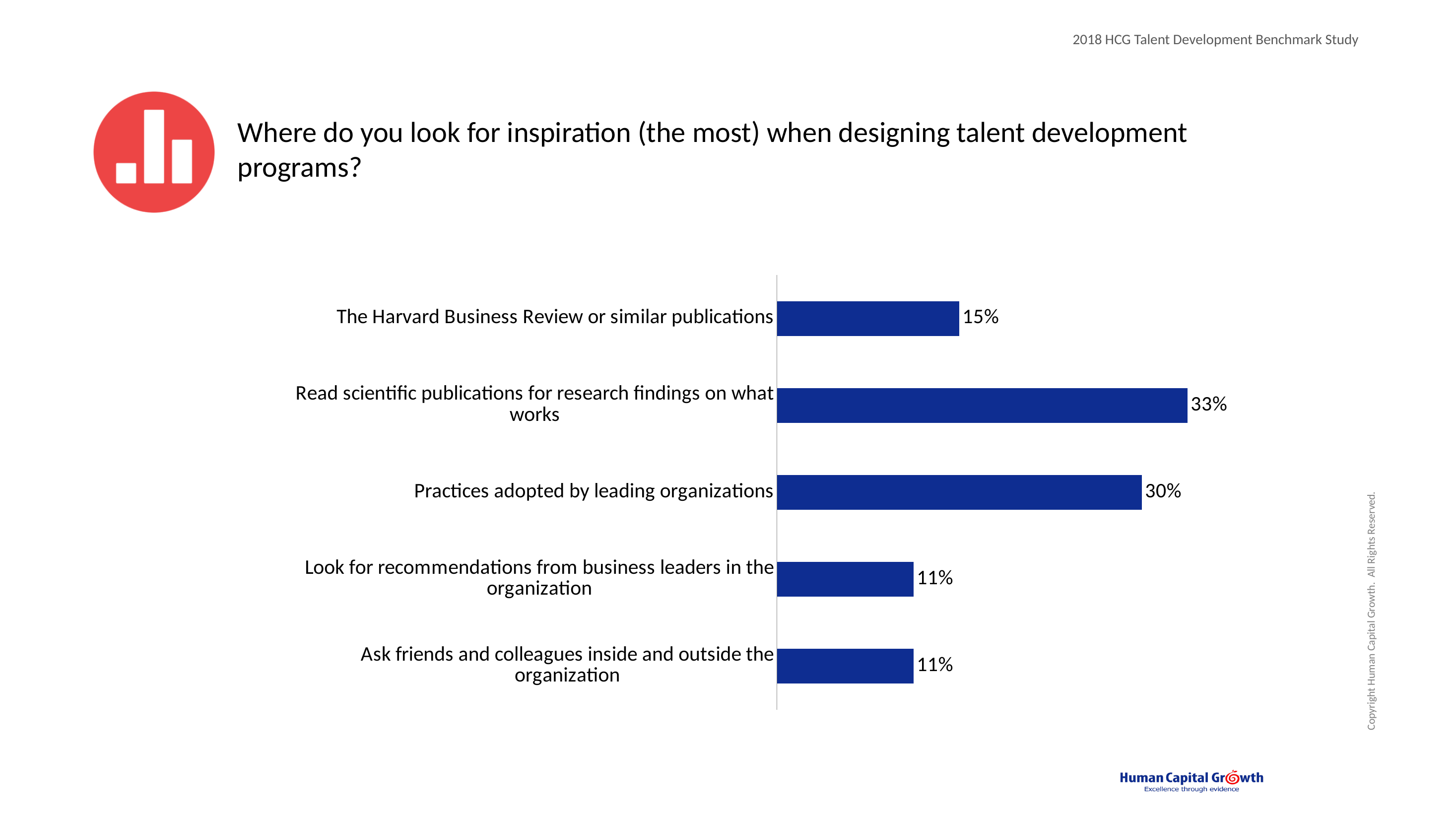
What is the difference between the percentage for the Harvard Business Review or similar publications and the percentage for asking friends and colleagues? 4% What percentage of respondents look to the Harvard Business Review or similar publications for inspiration? 15% What percentage look for recommendations from business leaders in the organization? 11% Which is larger: the value for 'Practices adopted by leading organizations' or the value for 'The Harvard Business Review or similar publications'? Practices adopted by leading organizations What kind of chart is shown on the slide? Bar chart What is the difference between the percentage for reading scientific publications and the percentage for practices adopted by leading organizations? 3% What is the value for 'Read scientific publications for research findings on what works'? 33% What colour are the bars in the chart? Dark blue How many categories are shown in the chart? 5 Which source of inspiration has the highest percentage? Read scientific publications for research findings on what works Which two categories share the same value of 11%? Look for recommendations from business leaders in the organization; Ask friends and colleagues inside and outside the organization What is the value for 'Practices adopted by leading organizations'? 30%